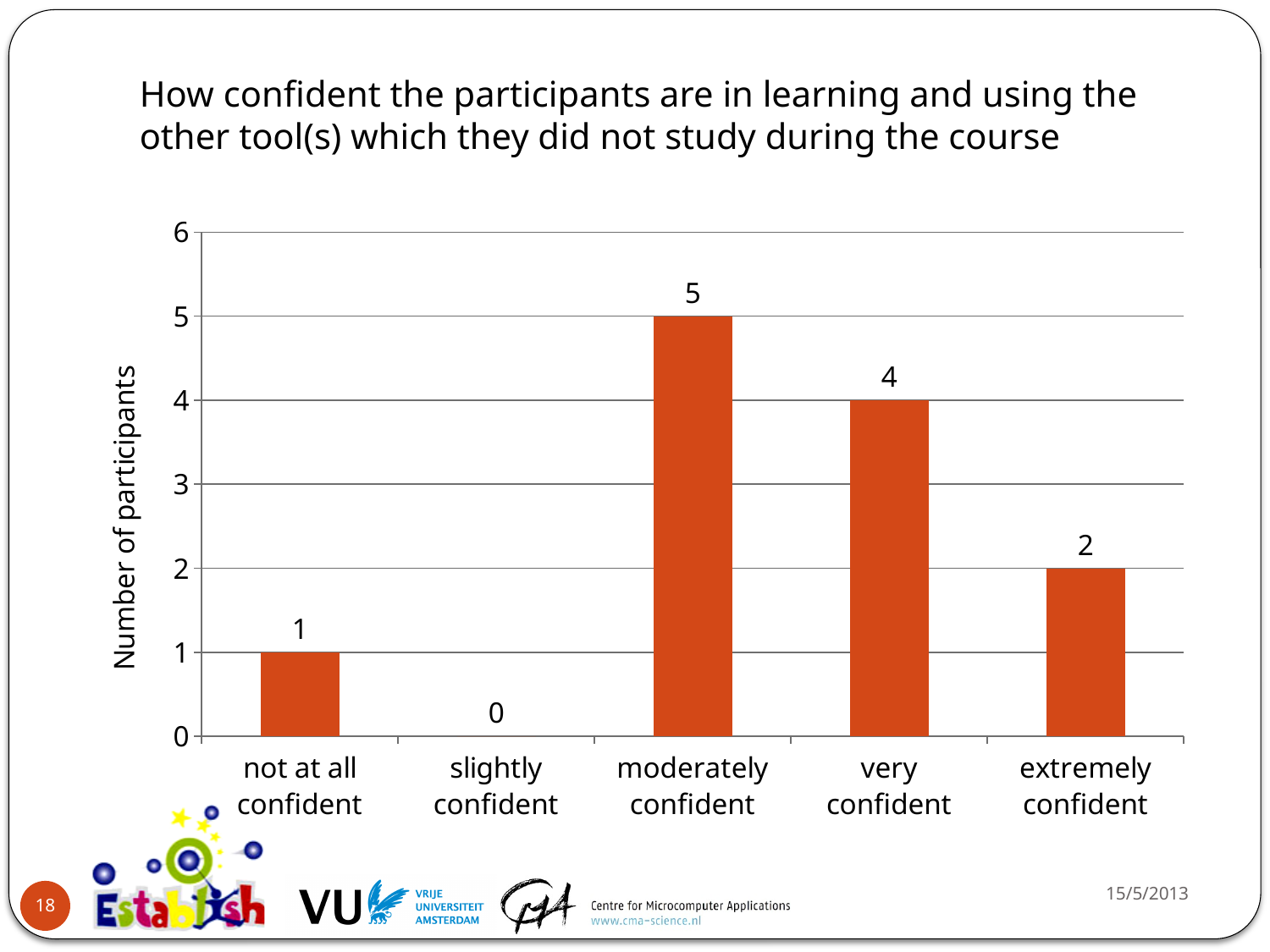
How many participants were not at all confident? 1 Which confidence level has the highest number of participants? moderately confident What is the difference between the number of moderately confident and very confident participants? 1 Which has more participants: very confident or extremely confident? very confident Which confidence level has the lowest number of participants? slightly confident How many confidence categories are shown on the x axis? 5 What is the total number of participants across all five categories? 12 How many participants were extremely confident? 2 How many participants were moderately confident? 5 What is the label of the y axis? Number of participants How many participants were slightly confident? 0 What kind of chart is shown on the slide? bar chart